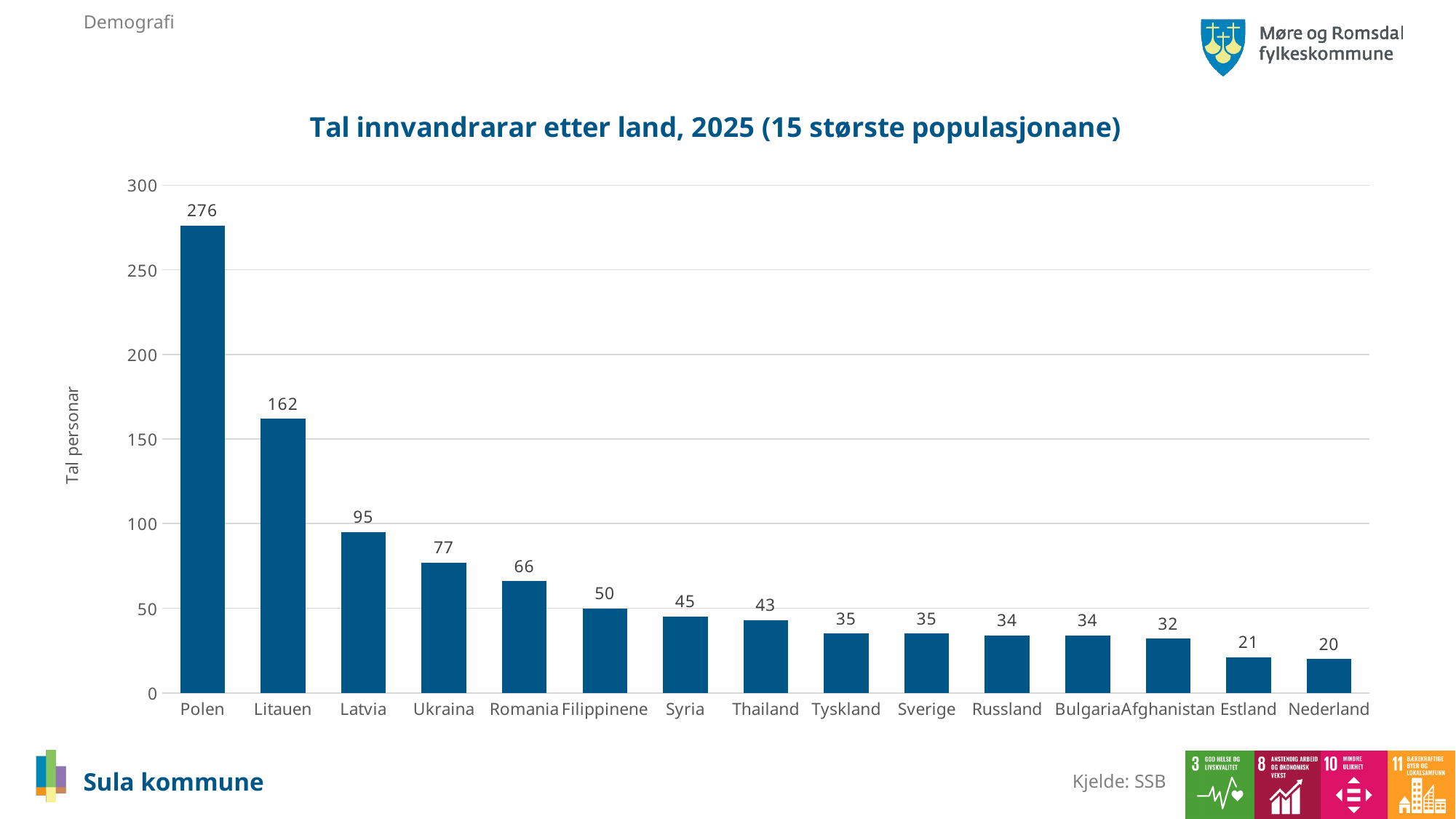
What is the difference between the values for Polen and Litauen? 114 What is the title of the chart? Tal innvandrarar etter land, 2025 (15 største populasjonane) What is the value for Afghanistan? 32 What is the difference between the values for Latvia and Romania? 29 What is the value for Ukraina? 77 Which is larger, the value for Syria or the value for Thailand? Syria How many countries are shown in the chart? 15 What is the value for Polen? 276 Which country has the highest value? Polen Which country has the lowest value? Nederland Is the value for Litauen greater or less than 150? greater What kind of chart is shown on the slide? bar chart